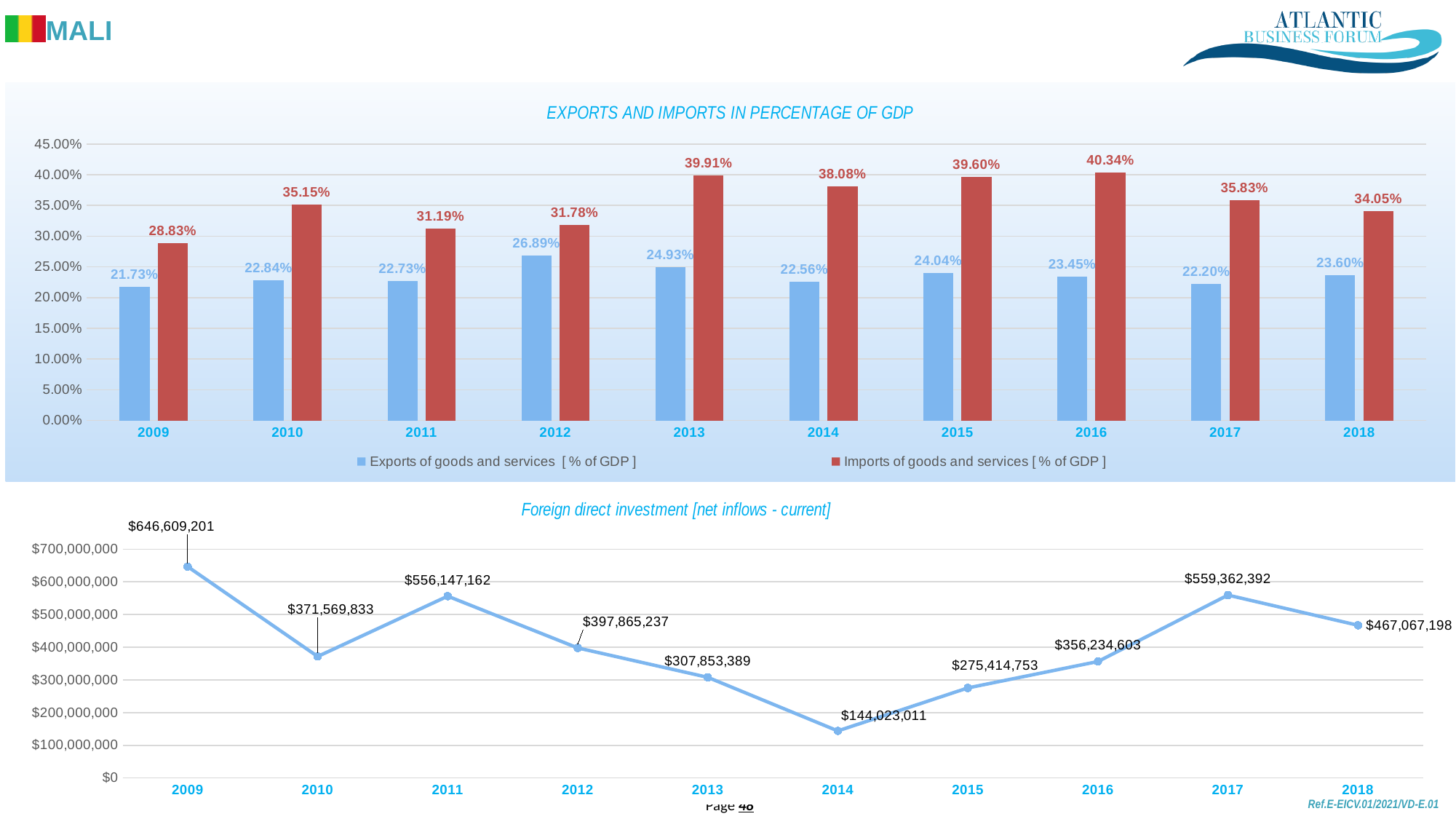
In the chart titled 'EXPORTS AND IMPORTS IN PERCENTAGE OF GDP', which year has the lowest value for Exports of goods and services? 2009 In the chart titled 'Foreign direct investment [net inflows - current]', what is the difference between the values for 2017 and 2016? $203,127,789 In the chart titled 'EXPORTS AND IMPORTS IN PERCENTAGE OF GDP', what type of chart is used? Bar chart In the chart titled 'EXPORTS AND IMPORTS IN PERCENTAGE OF GDP', what is the difference between Imports and Exports in 2016? 16.89% In the chart titled 'Foreign direct investment [net inflows - current]', which year has the highest value? 2009 In the chart titled 'Foreign direct investment [net inflows - current]', how many years are plotted? 10 In the chart titled 'Foreign direct investment [net inflows - current]', which is larger, the value for 2011 or the value for 2017? 2017 In the chart titled 'Foreign direct investment [net inflows - current]', what is the value for 2014? $144,023,011 In the chart titled 'EXPORTS AND IMPORTS IN PERCENTAGE OF GDP', which year has the highest value for Imports of goods and services? 2016 In the chart titled 'EXPORTS AND IMPORTS IN PERCENTAGE OF GDP', what is the value of Exports of goods and services in 2012? 26.89% In the chart titled 'EXPORTS AND IMPORTS IN PERCENTAGE OF GDP', what is the value of Imports of goods and services in 2013? 39.91% In the chart titled 'EXPORTS AND IMPORTS IN PERCENTAGE OF GDP', how many series does the legend list? 2